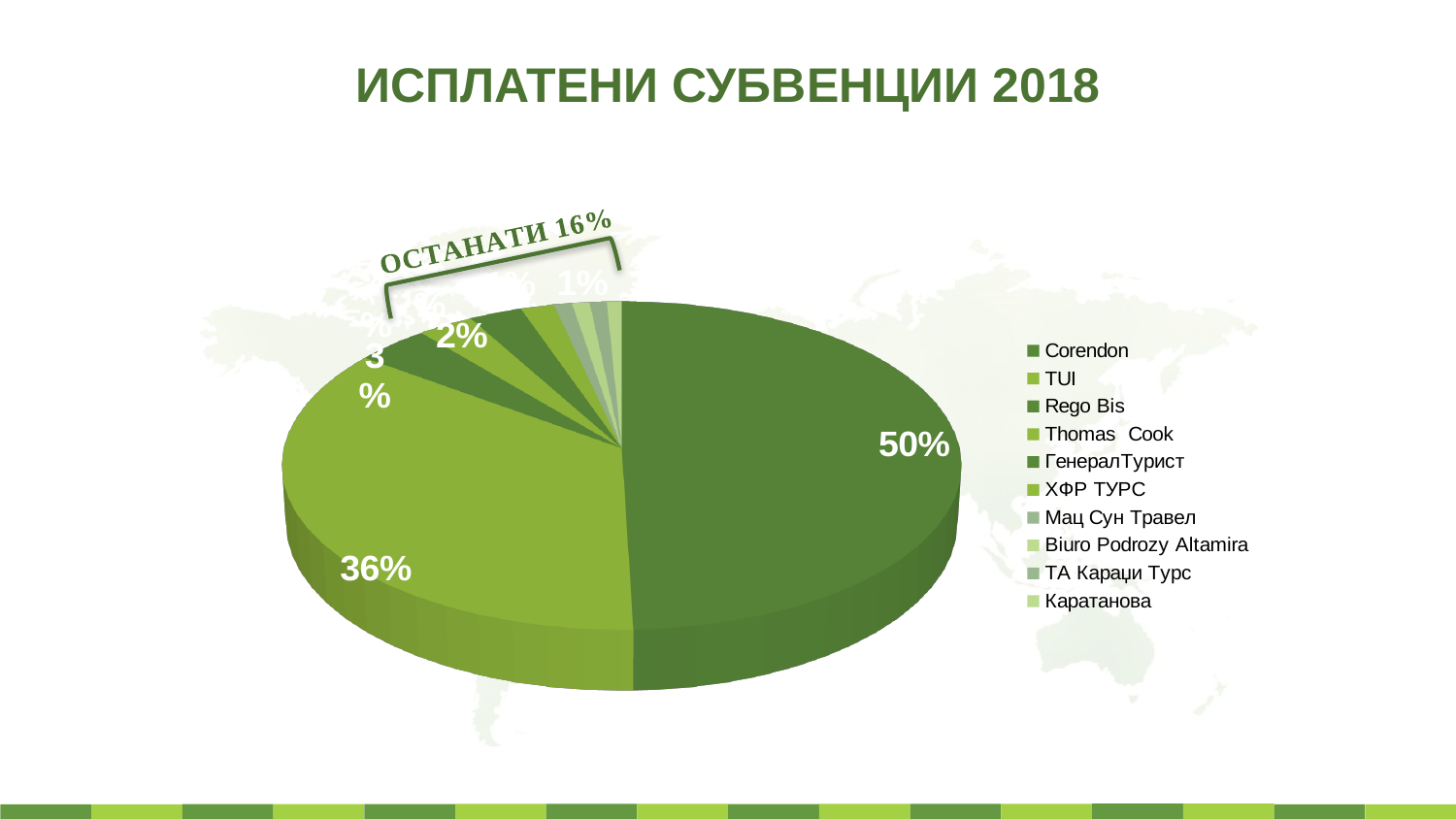
Which is larger, the slice for Corendon or the slice for TUI? Corendon What share of the pie does TUI have? 36% What is the difference in percentage points between the Corendon slice and the TUI slice? 14 What share of the pie does Corendon have? 50% What is the combined share of the Corendon and TUI slices? 86% According to the annotation on the chart, what share do the remaining (ОСТАНАТИ) categories have together? 16% Which category is listed first in the legend? Corendon What kind of chart is shown on the slide? pie chart Which category has the largest slice of the pie? Corendon How many categories does the legend of the pie chart list? 10 What is the title of the chart? ИСПЛАТЕНИ СУБВЕНЦИИ 2018